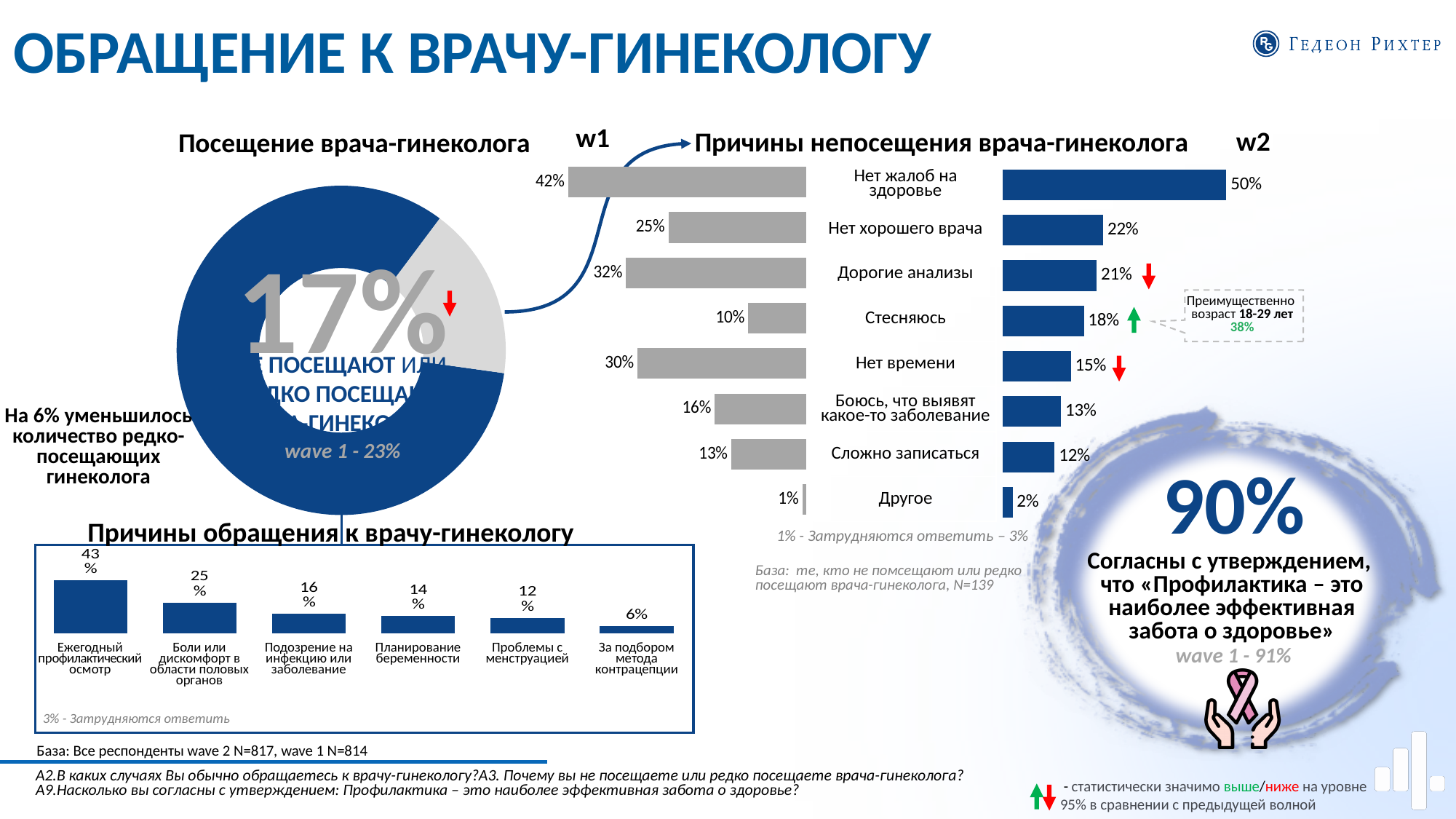
In the chart 'Причины обращения к врачу-гинекологу', what is the value for 'Ежегодный профилактический осмотр'? 43% In the chart 'Причины непосещения врача-гинеколога', what is the w1 value for 'Дорогие анализы'? 32% In the chart 'Причины непосещения врача-гинеколога', which reason has the highest w2 value? Нет жалоб на здоровье In the chart 'Причины обращения к врачу-гинекологу', what is the difference between 'Ежегодный профилактический осмотр' and 'Боли или дискомфорт в области половых органов'? 18% What type of chart is 'Причины обращения к врачу-гинекологу'? Bar chart In the chart 'Причины непосещения врача-гинеколога', what is the difference between the w1 and w2 values for 'Нет времени'? 15% In the chart 'Причины непосещения врача-гинеколога', what is the w2 value for 'Нет жалоб на здоровье'? 50% How many reasons are listed in the chart 'Причины непосещения врача-гинеколога'? 8 In the donut chart 'Посещение врача-гинеколога', what percentage is shown in the centre? 17% In the chart 'Причины непосещения врача-гинеколога', is the value for 'Стесняюсь' larger in w1 or w2? w2 How many waves (series) are shown in the chart 'Причины непосещения врача-гинеколога'? 2 In the chart 'Причины непосещения врача-гинеколога', which reason has the lowest w1 value? Другое